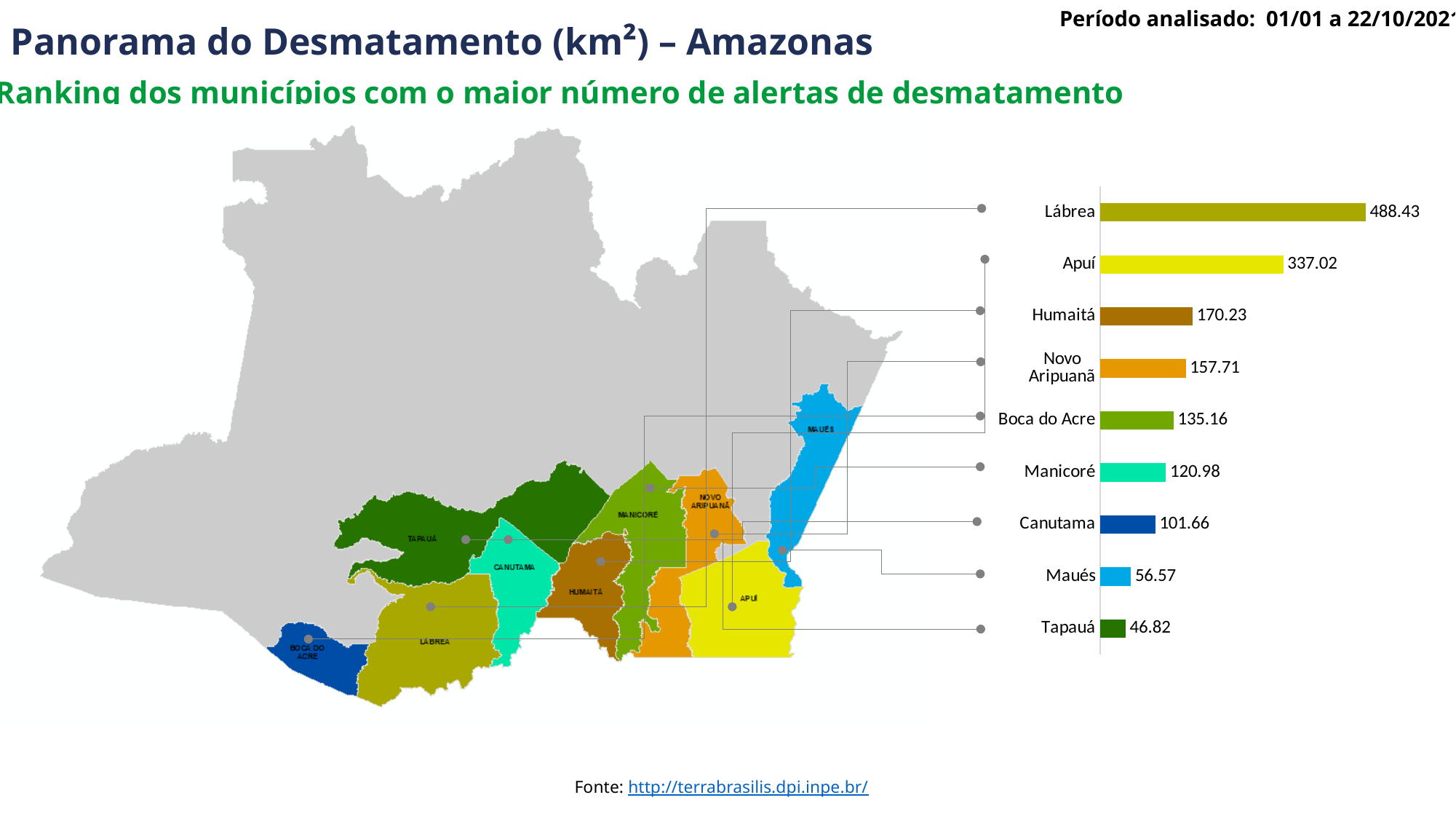
What is the value shown for Maués in the bar chart? 56.57 Which has a larger value, Manicoré or Canutama? Manicoré Which municipality has the lowest value in the bar chart? Tapauá What is the value shown for Canutama in the bar chart? 101.66 How many municipalities are shown in the bar chart? 9 What kind of chart is used to rank the municipalities? Bar chart What is the value shown for Lábrea in the bar chart? 488.43 What is the difference between the values for Humaitá and Novo Aripuanã? 12.52 What is the value shown for Novo Aripuanã in the bar chart? 157.71 Which has a larger value, Boca do Acre or Maués? Boca do Acre Which municipality has the highest value in the bar chart? Lábrea What is the difference between the values for Lábrea and Apuí? 151.41